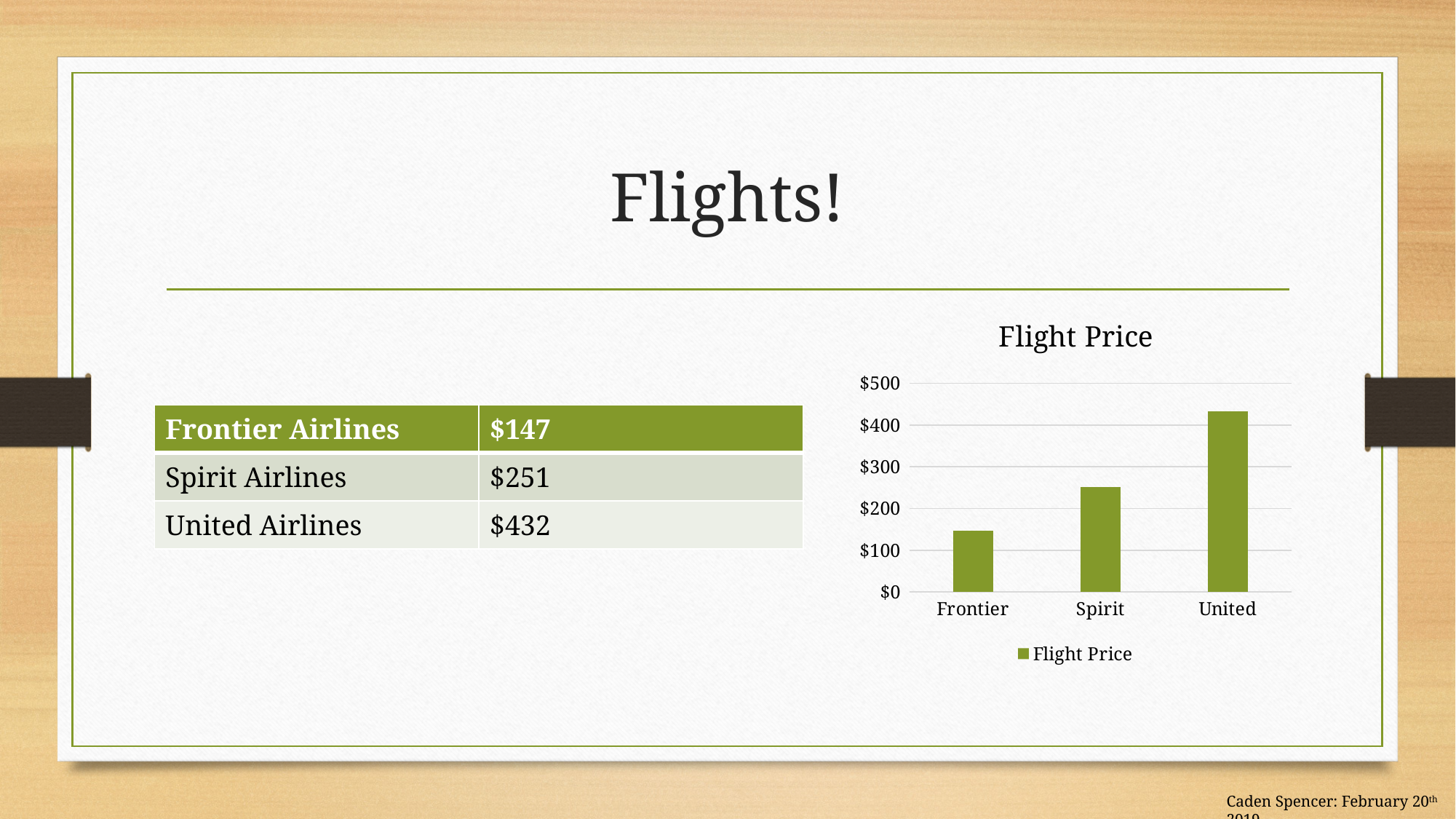
How many airlines are plotted in the Flight Price chart? 3 Is the flight price for United greater or less than $400? greater What is the title of the chart? Flight Price Is the flight price for Frontier greater or less than $200? less Which airline has the highest flight price in the chart? United What type of chart is shown on the slide? bar chart Which airline has the lowest flight price in the chart? Frontier What is the flight price for Frontier? $147 How many series does the chart legend list? 1 What is the flight price for United? $432 What is the flight price for Spirit? $251 How much more does the United flight cost than the Frontier flight? $285